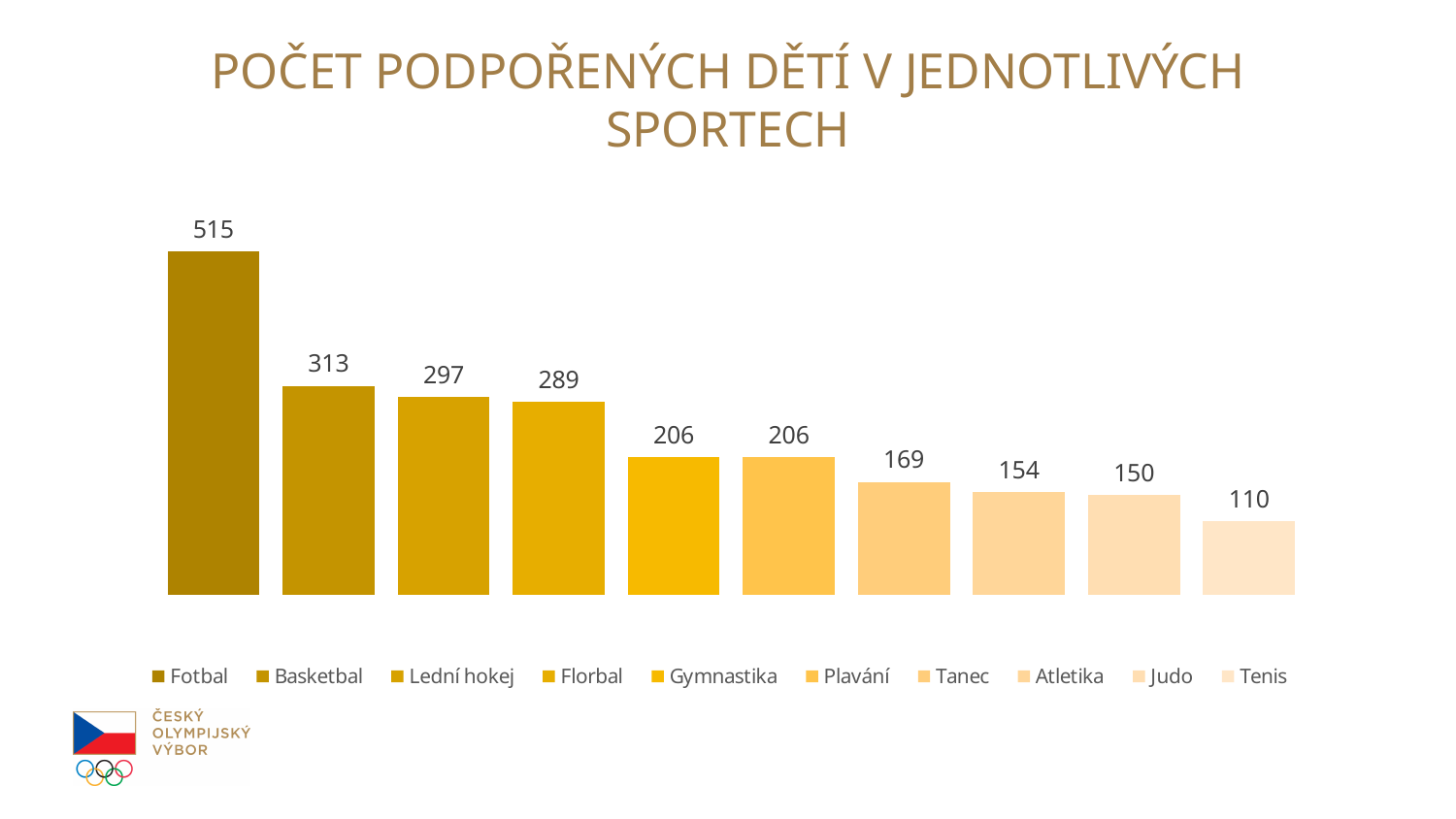
Which sport has the highest number of supported children? Fotbal How many entries does the legend list? 10 What is the value shown for Tanec? 169 Which has a larger value, Florbal or Gymnastika? Florbal What is the difference between the values for Fotbal and Basketbal? 202 What is the difference between the values for Atletika and Judo? 4 How many children were supported in Fotbal? 515 What is the value shown for Lední hokej? 297 Which sport has the lowest number of supported children? Tenis How many sports (bars) are shown in the chart? 10 Do the values rise or fall from left to right across the bars? Fall What type of chart is shown on the slide? Bar chart